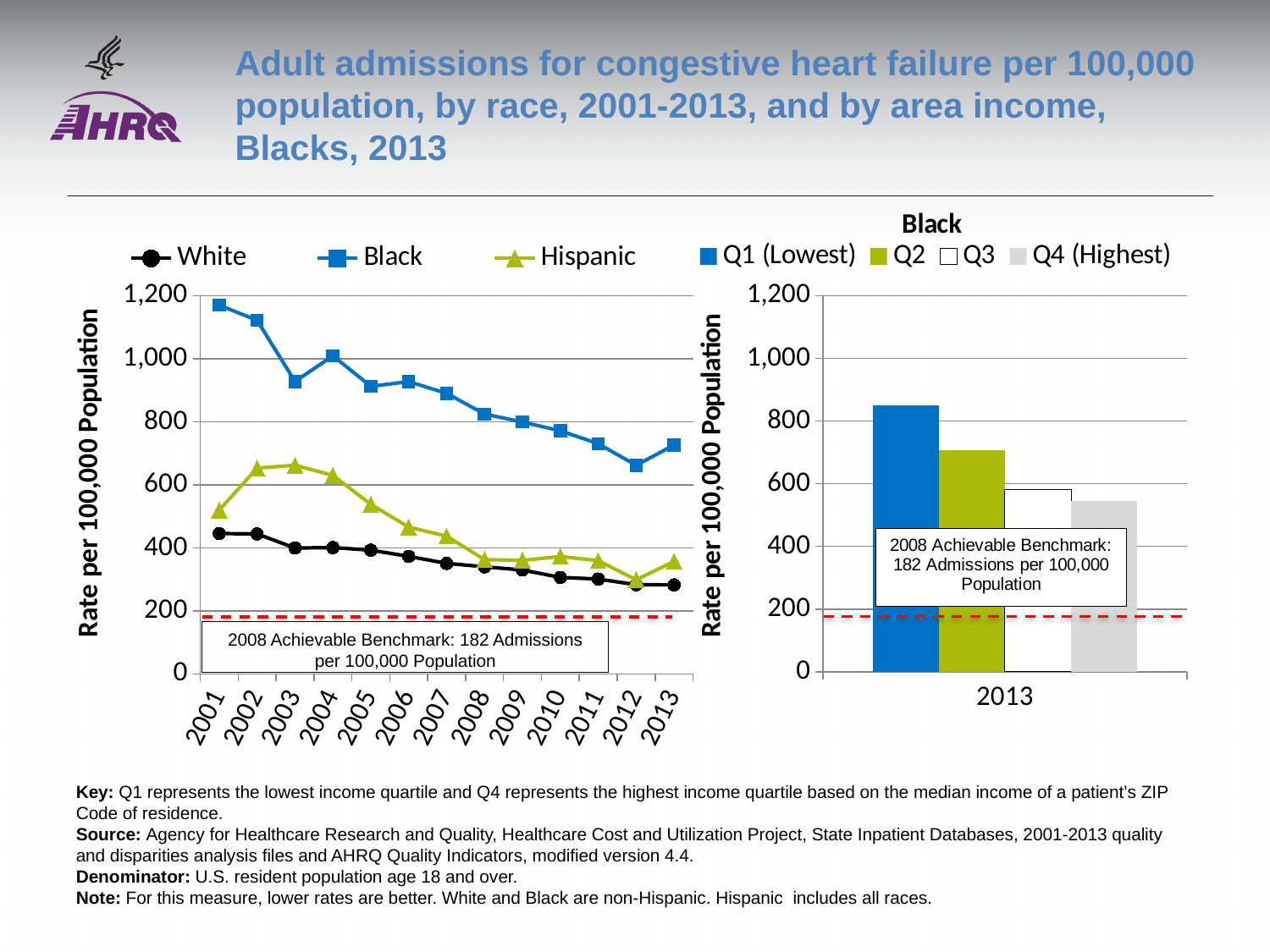
What is the 2008 Achievable Benchmark shown on the charts? 182 Admissions per 100,000 Population In the left chart, is the value for White in 2013 greater or less than 400? less In the right chart titled "Black", which income quartile has the highest rate in 2013? Q1 (Lowest) In the left chart, does the rate for Black rise or fall from 2001 to 2013? fall In the left chart, is the value for Black in 2001 greater or less than 1,000? greater In the left chart, how many series does the legend list? 3 In the right chart titled "Black", is the value for Q1 (Lowest) greater or less than 800? greater In the right chart titled "Black", how many series does the legend list? 4 What kind of chart is the right chart titled "Black"? bar chart In the left chart, how many years are shown on the x axis? 13 In the left chart, which race has the highest rate in 2001? Black What kind of chart is the left chart showing rates by race from 2001 to 2013? line chart